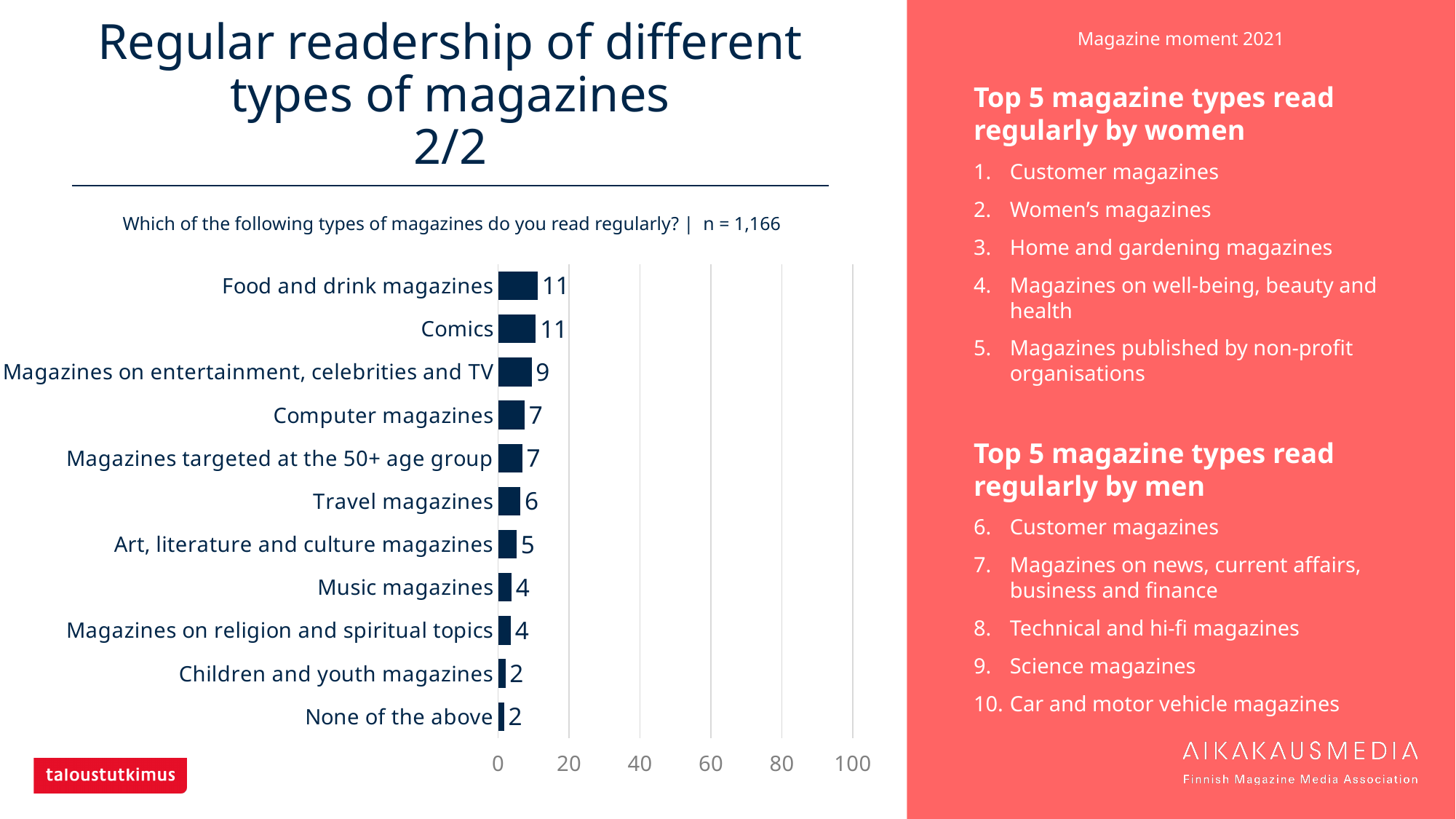
What is the value for Comics? 11 Which category has a larger value, Computer magazines or Travel magazines? Computer magazines What kind of chart is shown on the slide? bar chart What is the difference between the values for Comics and Music magazines? 7 What is the difference between the values for Food and drink magazines and Computer magazines? 4 Is the value for Magazines on entertainment, celebrities and TV greater or less than 20? less How many categories are shown in the chart? 11 What is the value for Magazines on entertainment, celebrities and TV? 9 What is the sample size (n) stated above the chart? n = 1,166 Which category has the lowest value, Music magazines or Art, literature and culture magazines? Music magazines What is the value for Children and youth magazines? 2 What is the value for Travel magazines? 6